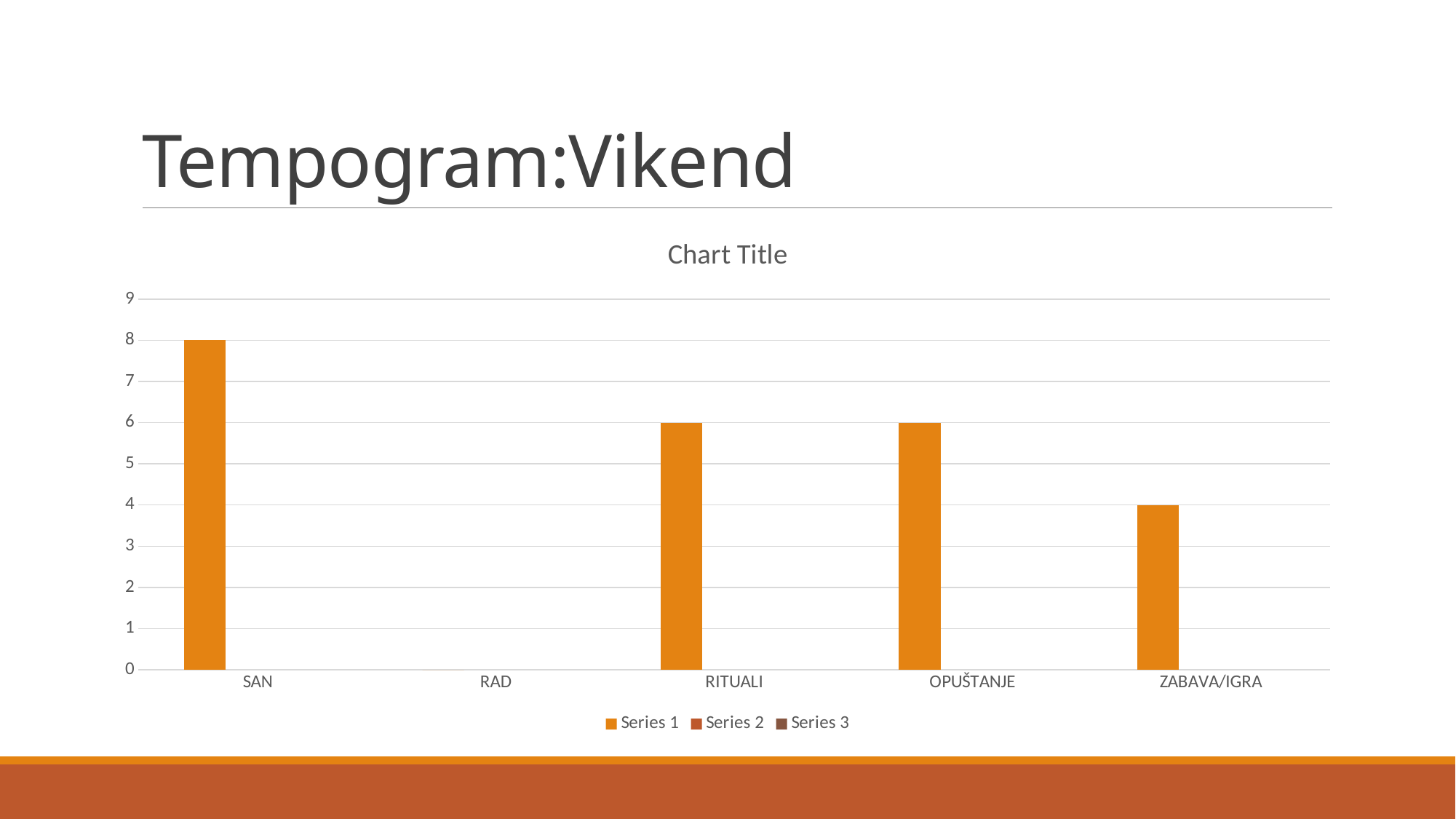
What is the title shown above the chart? Chart Title What is the Series 1 value for SAN? 8 What kind of chart is shown on the slide? bar chart What is the Series 1 value for ZABAVA/IGRA? 4 Is the Series 1 value for SAN greater or less than 5? greater How many series does the legend list? 3 Which category has the lowest Series 1 value? RAD Which is larger, the Series 1 value for OPUŠTANJE or for ZABAVA/IGRA? OPUŠTANJE What is the difference between the Series 1 values for SAN and ZABAVA/IGRA? 4 What is the Series 1 value for RITUALI? 6 How many categories are shown on the x axis? 5 Which category has the highest Series 1 value? SAN